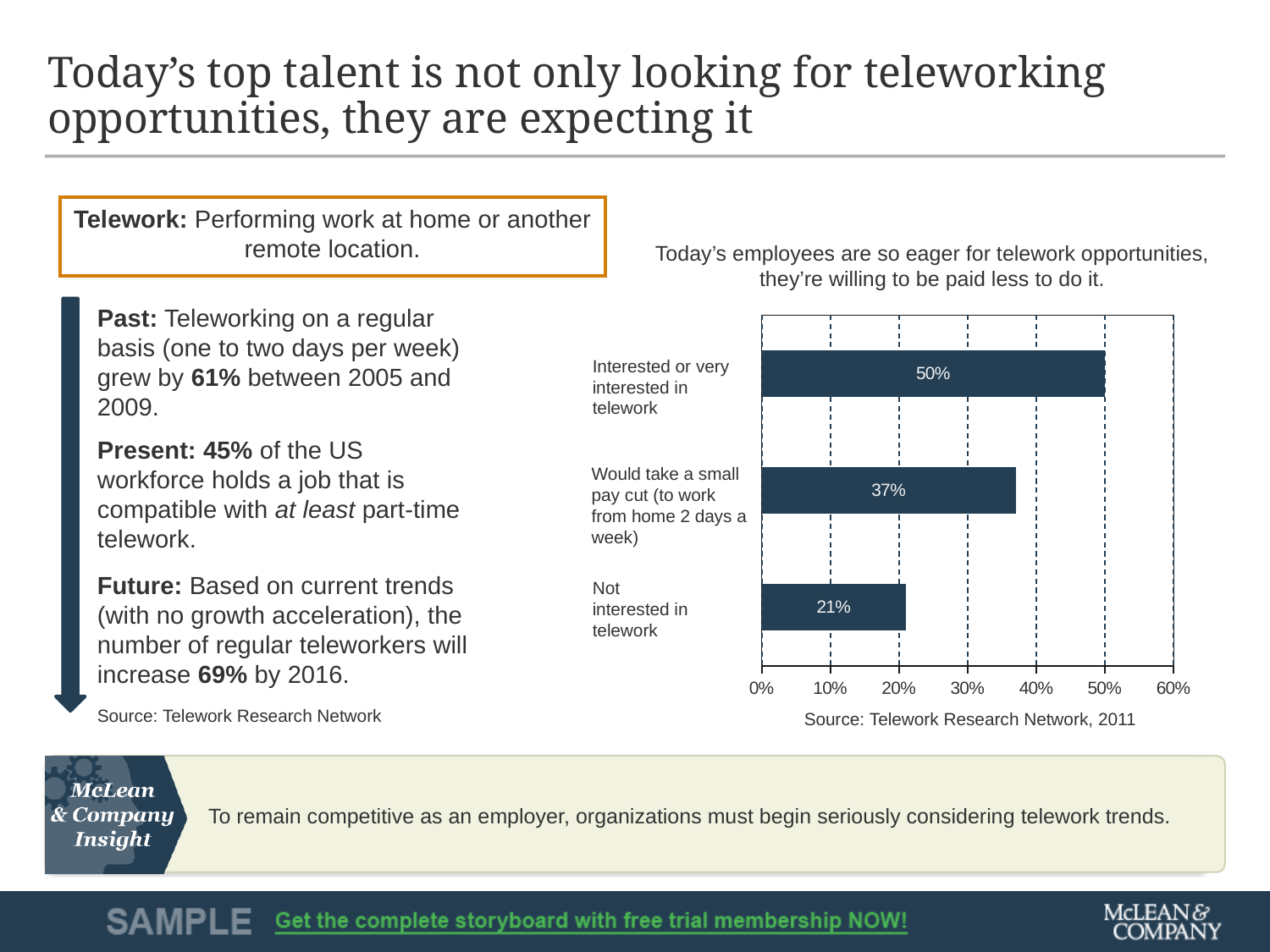
What percentage of employees would take a small pay cut to work from home 2 days a week? 37% What percentage of employees are interested or very interested in telework? 50% What kind of chart is shown on the slide? Bar chart Which category has the lowest value in the chart? Not interested in telework What is the difference between the share interested or very interested in telework and the share that would take a small pay cut? 13% What is the difference between the share interested or very interested in telework and the share not interested in telework? 29% Is the value for 'Would take a small pay cut' greater or less than 40%? less What percentage of employees are not interested in telework? 21% How many categories are shown in the chart? 3 What is the maximum value shown on the chart's horizontal axis? 60% Which category has the highest value in the chart? Interested or very interested in telework Which is larger: the share that would take a small pay cut or the share not interested in telework? Would take a small pay cut